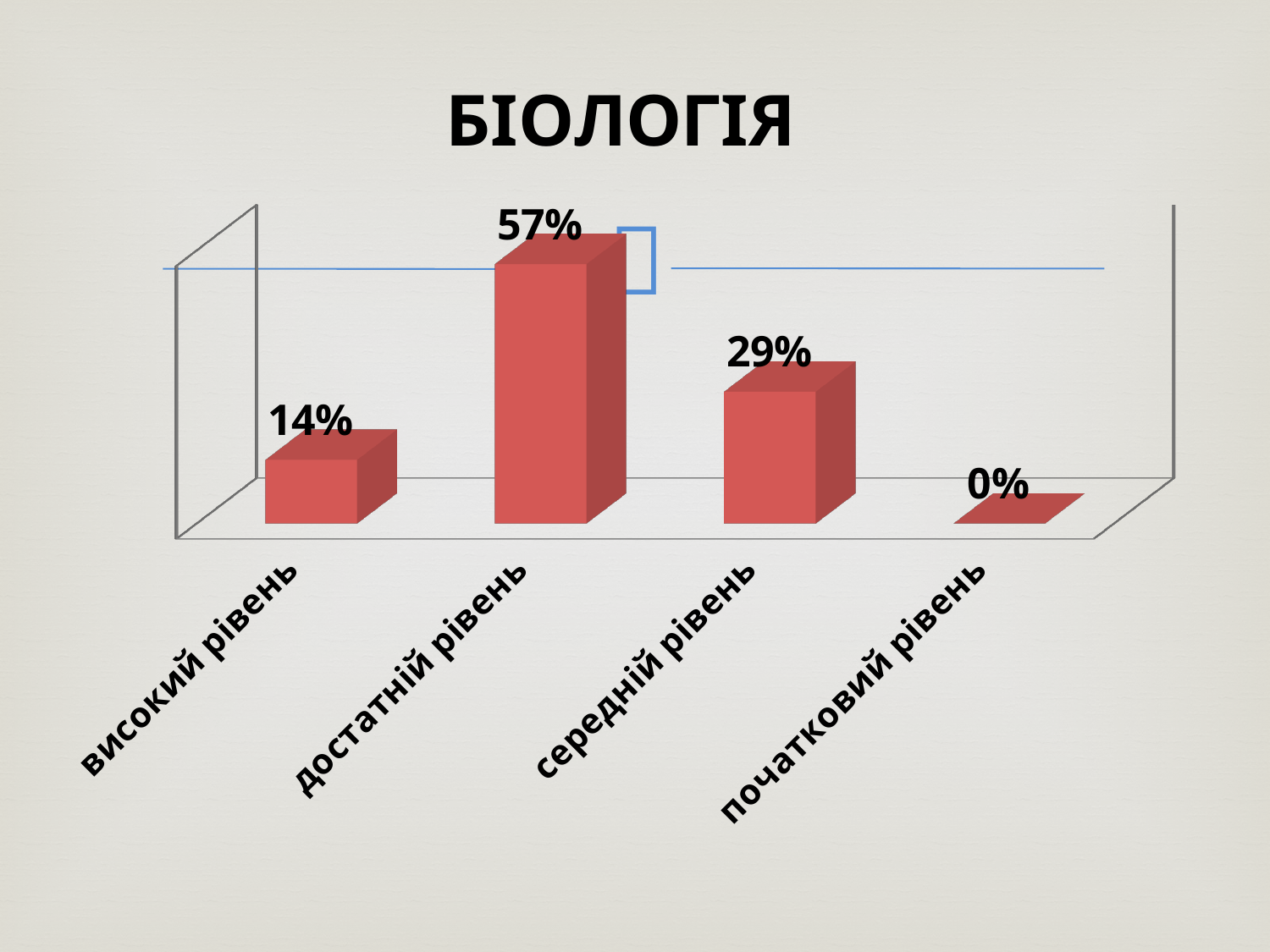
Which is larger, the value for високий рівень or the value for середній рівень? середній рівень Which category has the highest value? достатній рівень Which category has the lowest value? початковий рівень How many categories are shown in the chart? 4 What is the value for початковий рівень? 0% What is the title of the slide? БІОЛОГІЯ What is the value for високий рівень? 14% What is the difference between the values for достатній рівень and середній рівень? 28% What is the difference between the values for середній рівень and високий рівень? 15% What kind of chart is shown on the slide? bar chart What is the value for середній рівень? 29% What is the value for достатній рівень? 57%